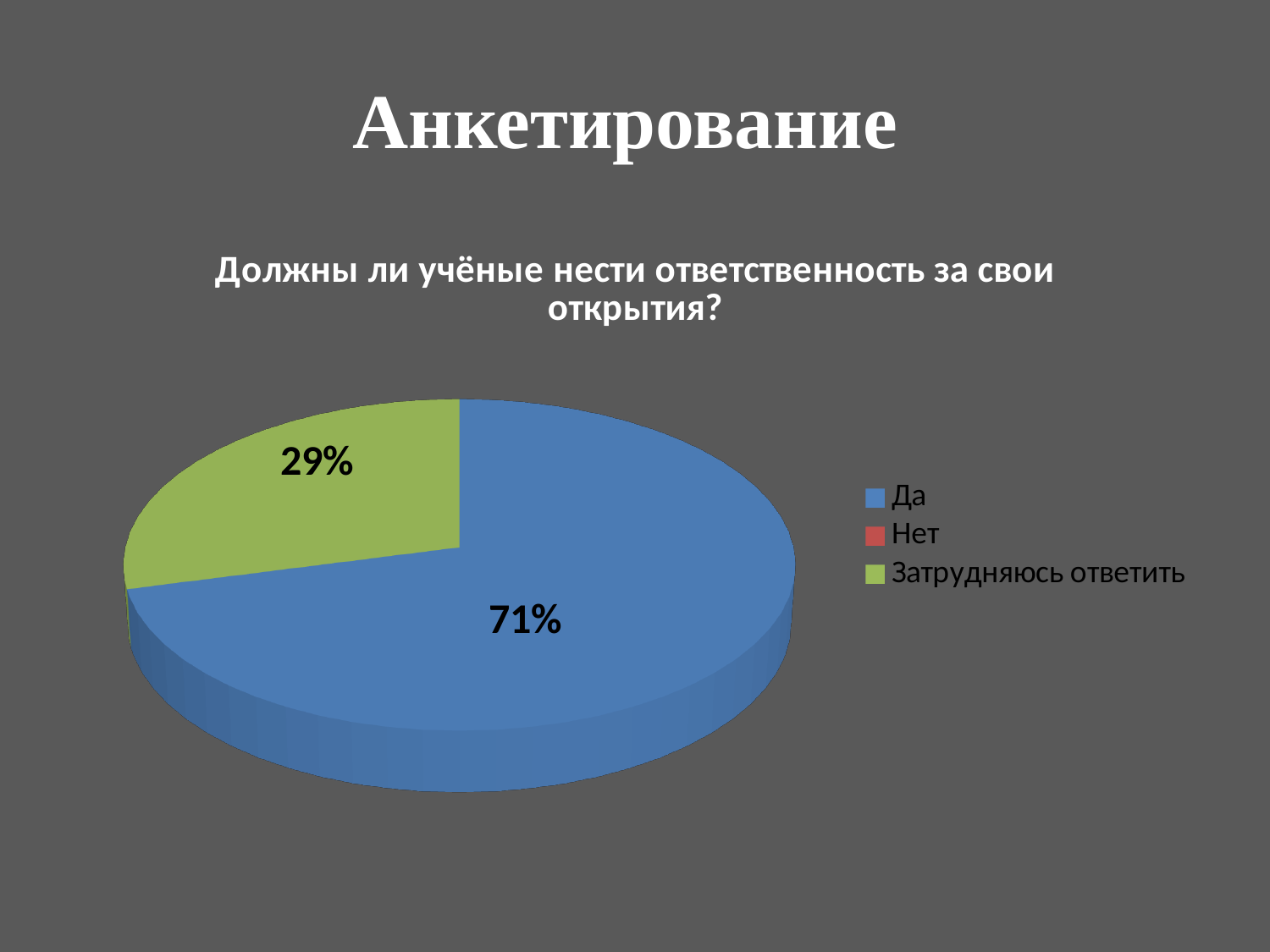
What share of the pie does the "Затрудняюсь ответить" slice represent? 29% What is the difference in percentage points between the "Да" and "Затрудняюсь ответить" slices? 42 What colour is the "Да" slice? Blue Which is larger, the "Да" slice or the "Затрудняюсь ответить" slice? Да Is the share for "Да" greater or less than 50%? greater How many entries does the legend list? 3 How many slices with a visible data label are shown in the pie? 2 What kind of chart is shown on the slide? Pie chart What share of the pie does the "Да" slice represent? 71% What is the title of the chart? Должны ли учёные нести ответственность за свои открытия? Which category has the largest slice of the pie? Да